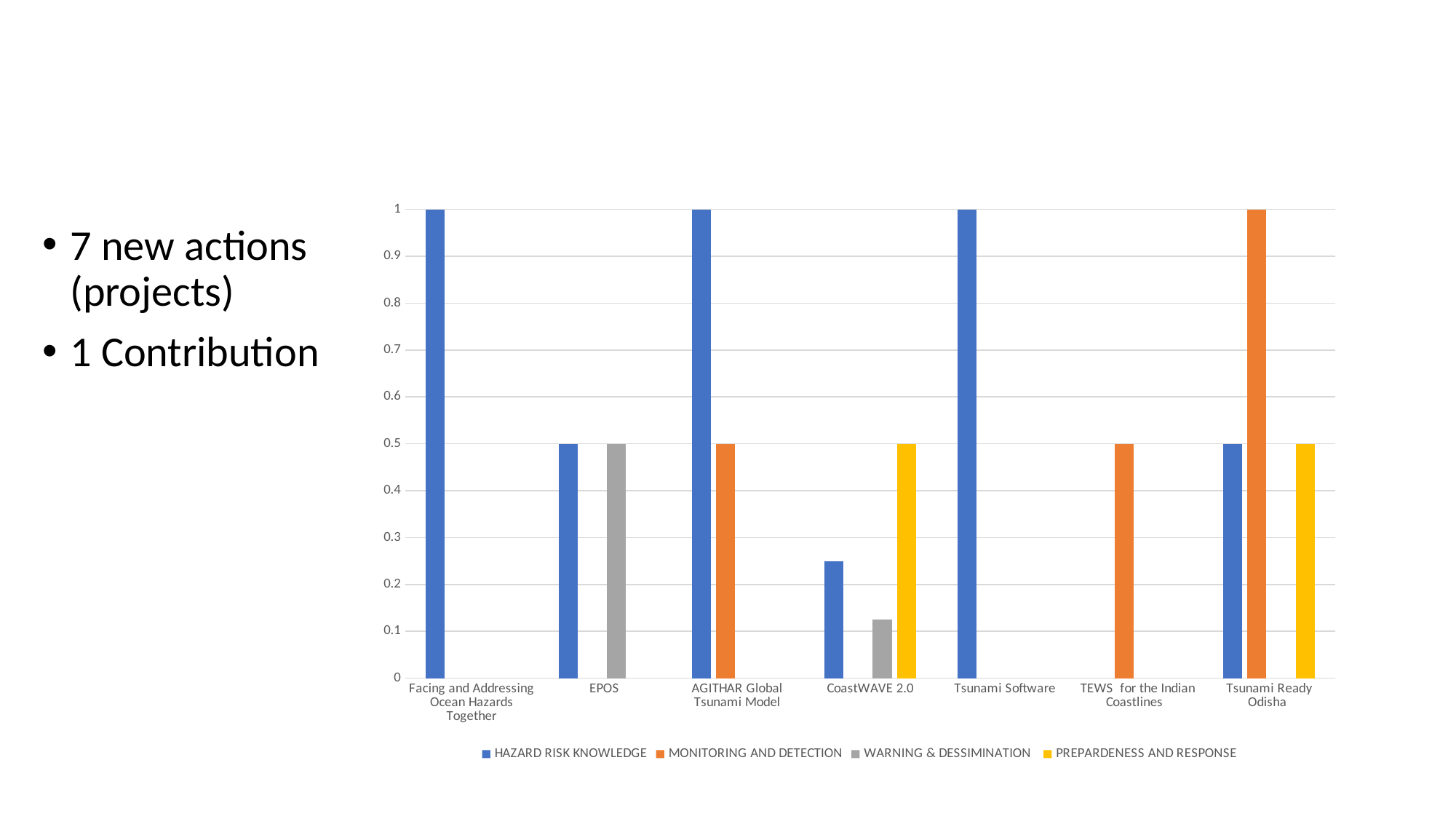
What is the difference between the HAZARD RISK KNOWLEDGE value for Tsunami Software and for Tsunami Ready Odisha? 0.5 Which series is shown in orange in the legend? MONITORING AND DETECTION How many series does the legend list? 4 Is the HAZARD RISK KNOWLEDGE value for CoastWAVE 2.0 greater or less than 0.5? less What is the WARNING & DESSIMINATION value for EPOS? 0.5 What kind of chart is shown on the slide? bar chart How many categories are shown on the x axis? 7 What is the HAZARD RISK KNOWLEDGE value for EPOS? 0.5 What is the MONITORING AND DETECTION value for Tsunami Ready Odisha? 1 What is the HAZARD RISK KNOWLEDGE value for Tsunami Software? 1 Which is larger: the HAZARD RISK KNOWLEDGE value for AGITHAR Global Tsunami Model or for EPOS? AGITHAR Global Tsunami Model Is the WARNING & DESSIMINATION value for CoastWAVE 2.0 greater or less than 0.2? less